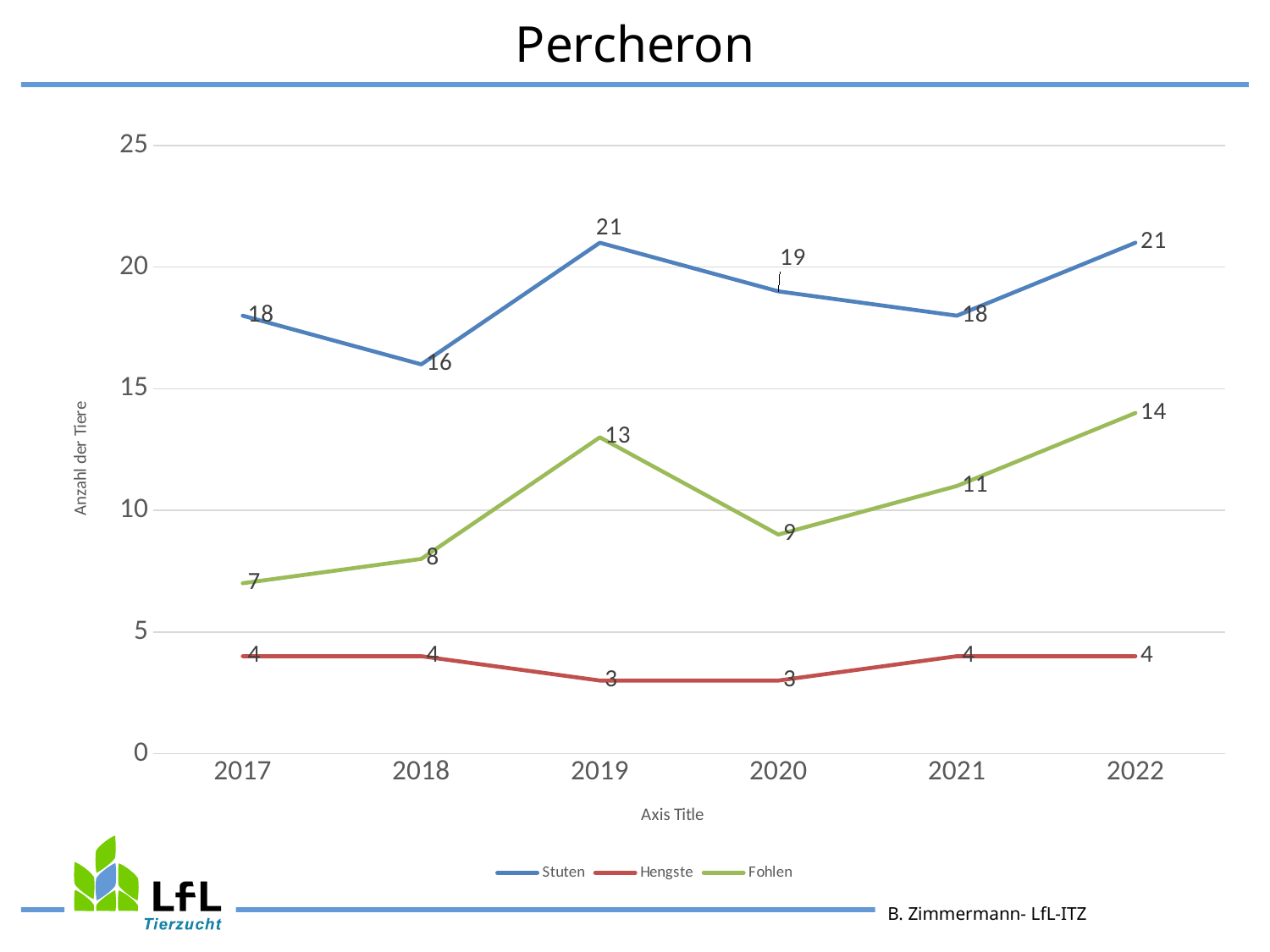
Is the Stuten value in 2020 greater or less than 15? greater In which year is the Fohlen value highest? 2022 What kind of chart is shown on the slide? line chart What is the difference between the Stuten and Fohlen values in 2022? 7 How many years are shown on the x axis? 6 What is the value for Fohlen in 2020? 9 What is the value for Stuten in 2019? 21 What is the value for Hengste in 2021? 4 Does the Fohlen series rise or fall from 2020 to 2022? rise In which year is the Stuten value lowest? 2018 How many series does the legend list? 3 Which is larger, the Fohlen value in 2019 or the Fohlen value in 2021? Fohlen in 2019